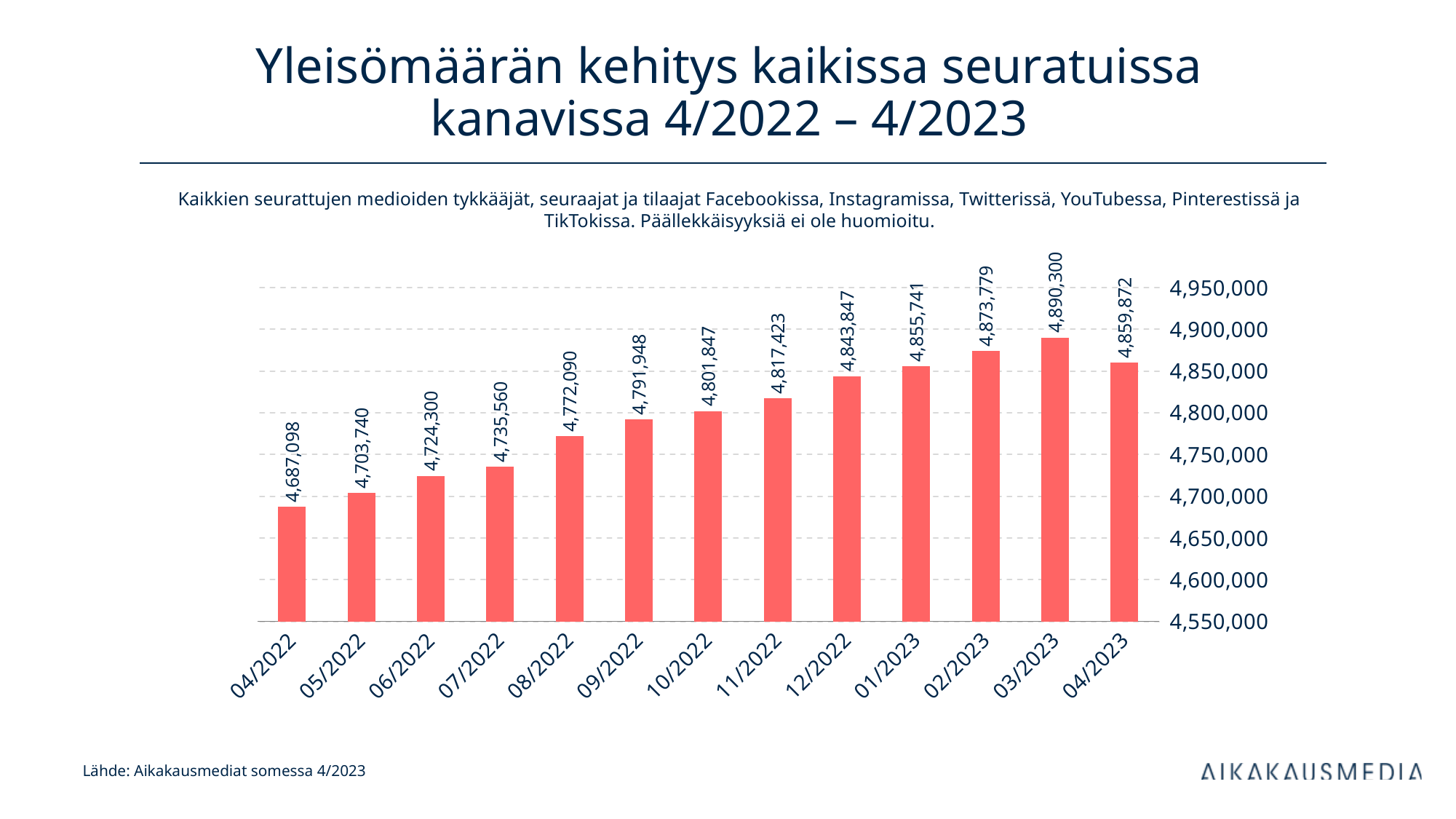
Which is larger, the value for 02/2023 or the value for 04/2023? 02/2023 What is the value for 03/2023? 4,890,300 What is the value for 10/2022? 4,801,847 What is the difference between the values for 03/2023 and 04/2022? 203,202 Which month has the highest value? 03/2023 How many months are shown on the x axis? 13 Do the values generally rise or fall from 04/2022 to 03/2023? Rise What is the value for 04/2022? 4,687,098 What kind of chart is shown on the slide? Bar chart What is the difference between the values for 03/2023 and 04/2023? 30,428 What is the value for 04/2023? 4,859,872 Which month has the lowest value? 04/2022